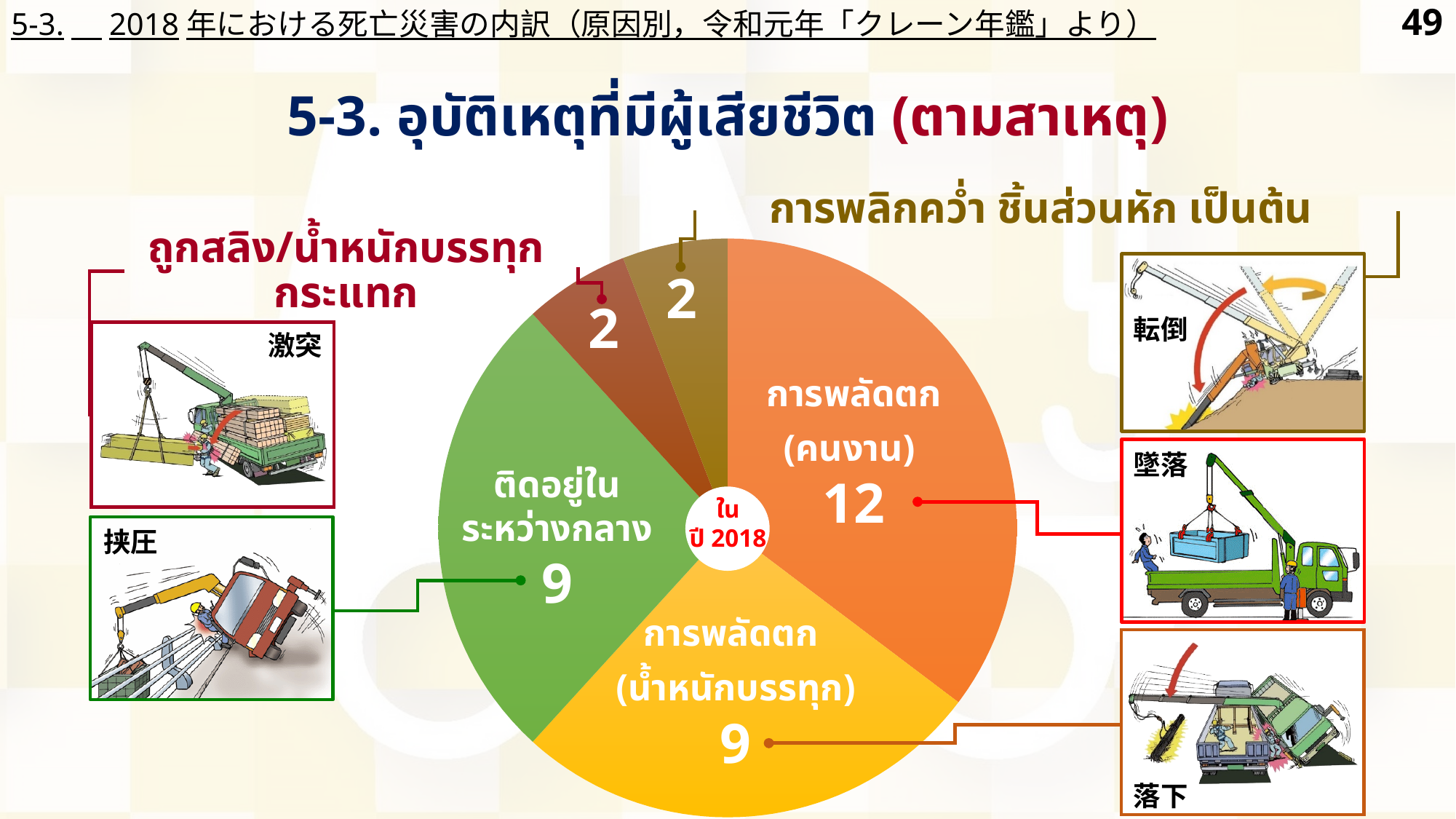
What is the value for การพลัดตก (คนงาน)? 12 Which category has the highest value in the pie chart? การพลัดตก (คนงาน) What is the total of all the values shown in the pie chart? 34 What kind of chart is shown on the slide? Pie chart What is the difference between the values for การพลัดตก (คนงาน) and ติดอยู่ในระหว่างกลาง? 3 What is the value for ติดอยู่ในระหว่างกลาง? 9 Which is larger, the value for การพลัดตก (คนงาน) or the value for การพลิกคว่ำ ชิ้นส่วนหัก เป็นต้น? การพลัดตก (คนงาน) What is the value for การพลิกคว่ำ ชิ้นส่วนหัก เป็นต้น? 2 What is the value for ถูกสลิง/น้ำหนักบรรทุกกระแทก? 2 What is the value for การพลัดตก (น้ำหนักบรรทุก)? 9 What year is written in the centre of the pie chart? 2018 How many slices does the pie chart have? 5